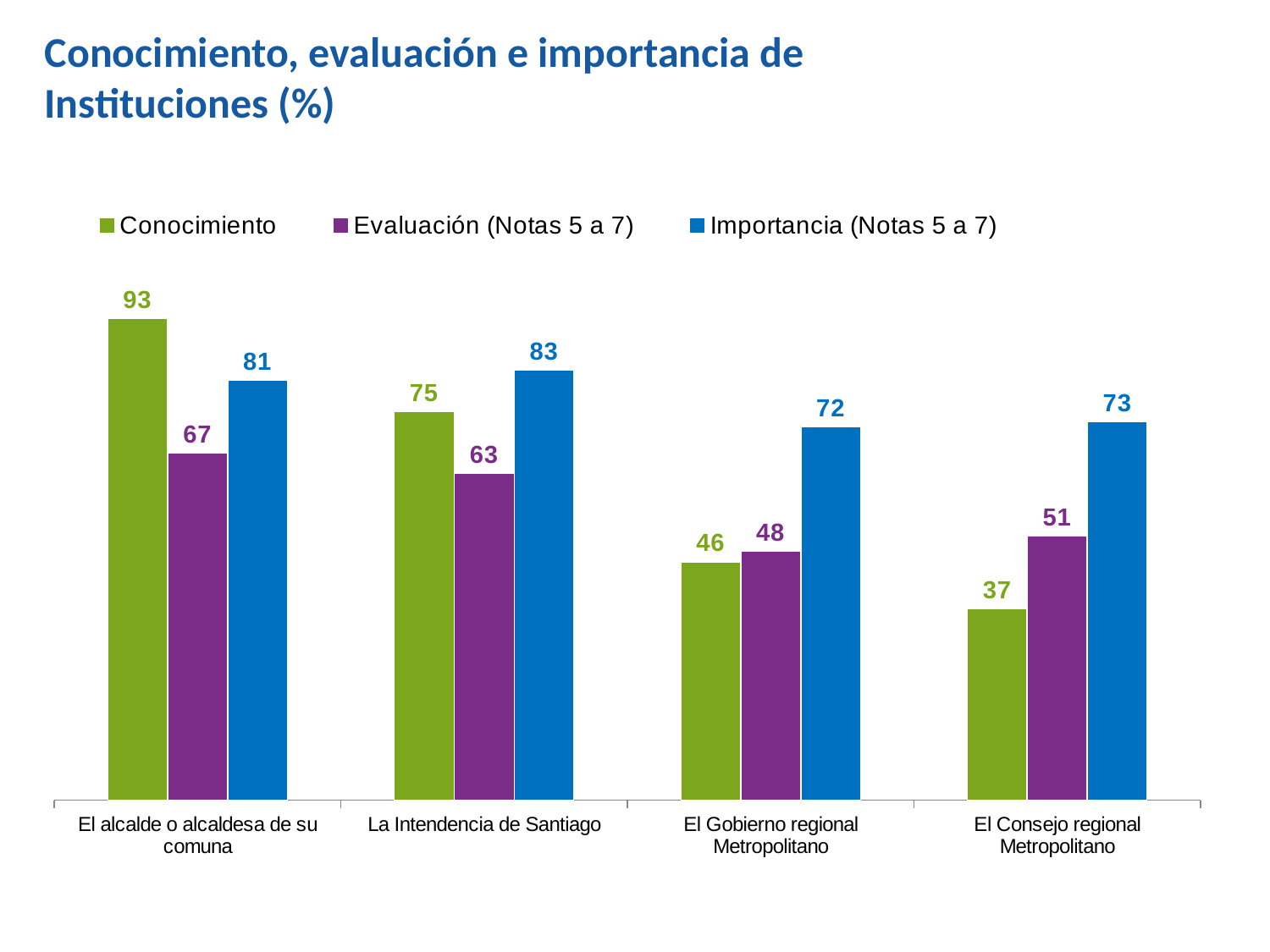
Which is larger for El Gobierno regional Metropolitano: Conocimiento or Importancia (Notas 5 a 7)? Importancia (Notas 5 a 7) Which institution has the highest Conocimiento value? El alcalde o alcaldesa de su comuna Which institution has the lowest Conocimiento value? El Consejo regional Metropolitano What is the Conocimiento value for El alcalde o alcaldesa de su comuna? 93 Do the Conocimiento values rise or fall from left to right across the institutions? Fall What is the Importancia (Notas 5 a 7) value for La Intendencia de Santiago? 83 What is the difference between the Conocimiento and Evaluación (Notas 5 a 7) values for El alcalde o alcaldesa de su comuna? 26 What kind of chart is shown on the slide? Bar chart How many institutions are shown on the x axis? 4 What is the Evaluación (Notas 5 a 7) value for El Consejo regional Metropolitano? 51 What colour are the Importancia (Notas 5 a 7) bars? Blue How many series does the legend list? 3